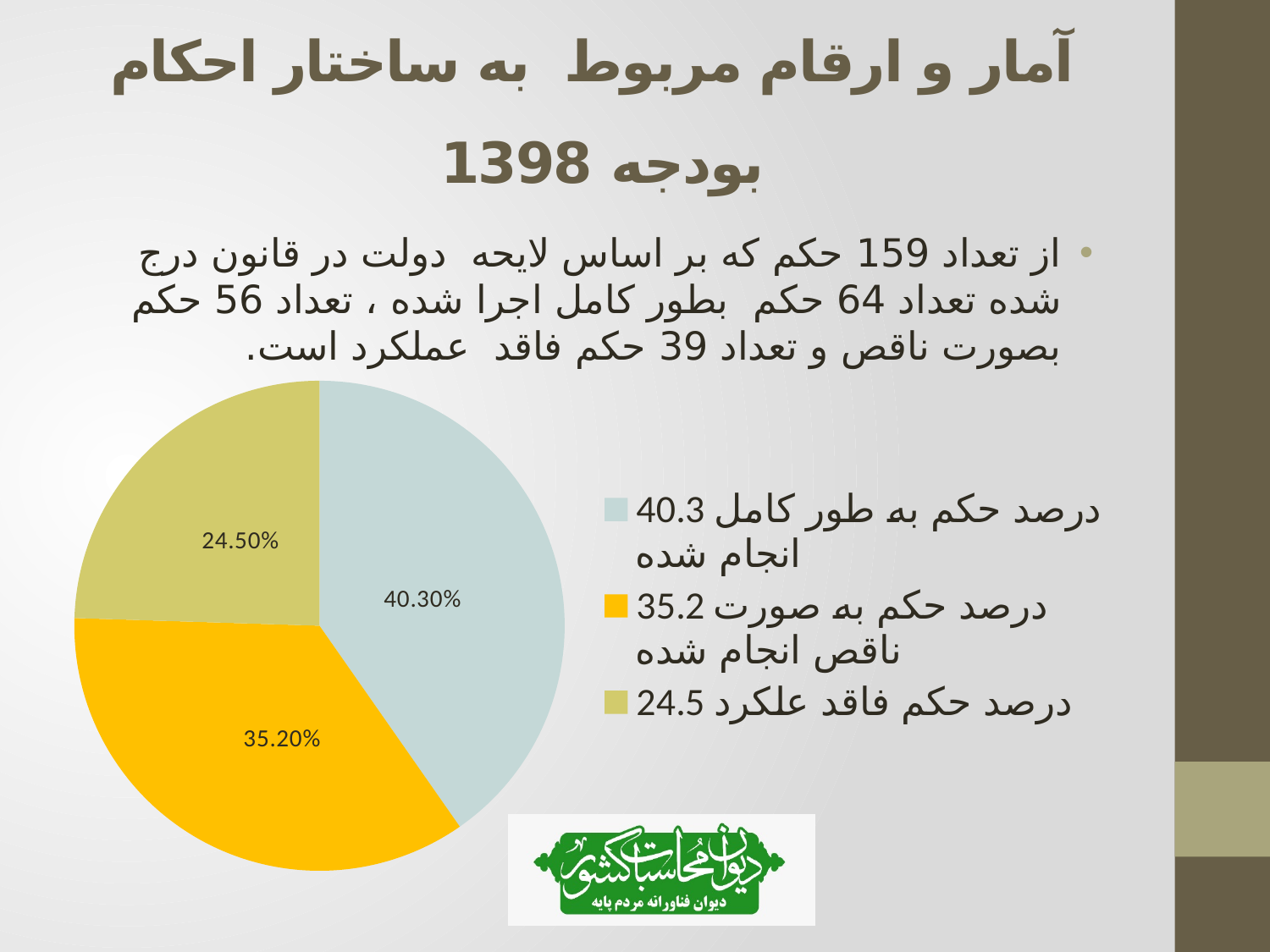
Which is larger: the slice for 'درصد حکم به صورت ناقص انجام شده' or the slice for 'درصد حکم فاقد علکرد'? درصد حکم به صورت ناقص انجام شده What is the data label on the slice for 'درصد حکم به طور کامل انجام شده'? 40.30% Which slice of the pie chart is the largest? درصد حکم به طور کامل انجام شده What is the difference between the largest slice (40.30%) and the smallest slice (24.50%)? 15.80% What colour is the slice labelled 35.20%? orange How many entries does the legend of the pie chart list? 3 What is the data label on the slice for 'درصد حکم فاقد علکرد'? 24.50% Which slice of the pie chart is the smallest? درصد حکم فاقد علکرد What colour is the slice labelled 40.30%? light blue-gray What is the data label on the slice for 'درصد حکم به صورت ناقص انجام شده'? 35.20% How many slices does the pie chart have? 3 What kind of chart is shown on the slide? pie chart